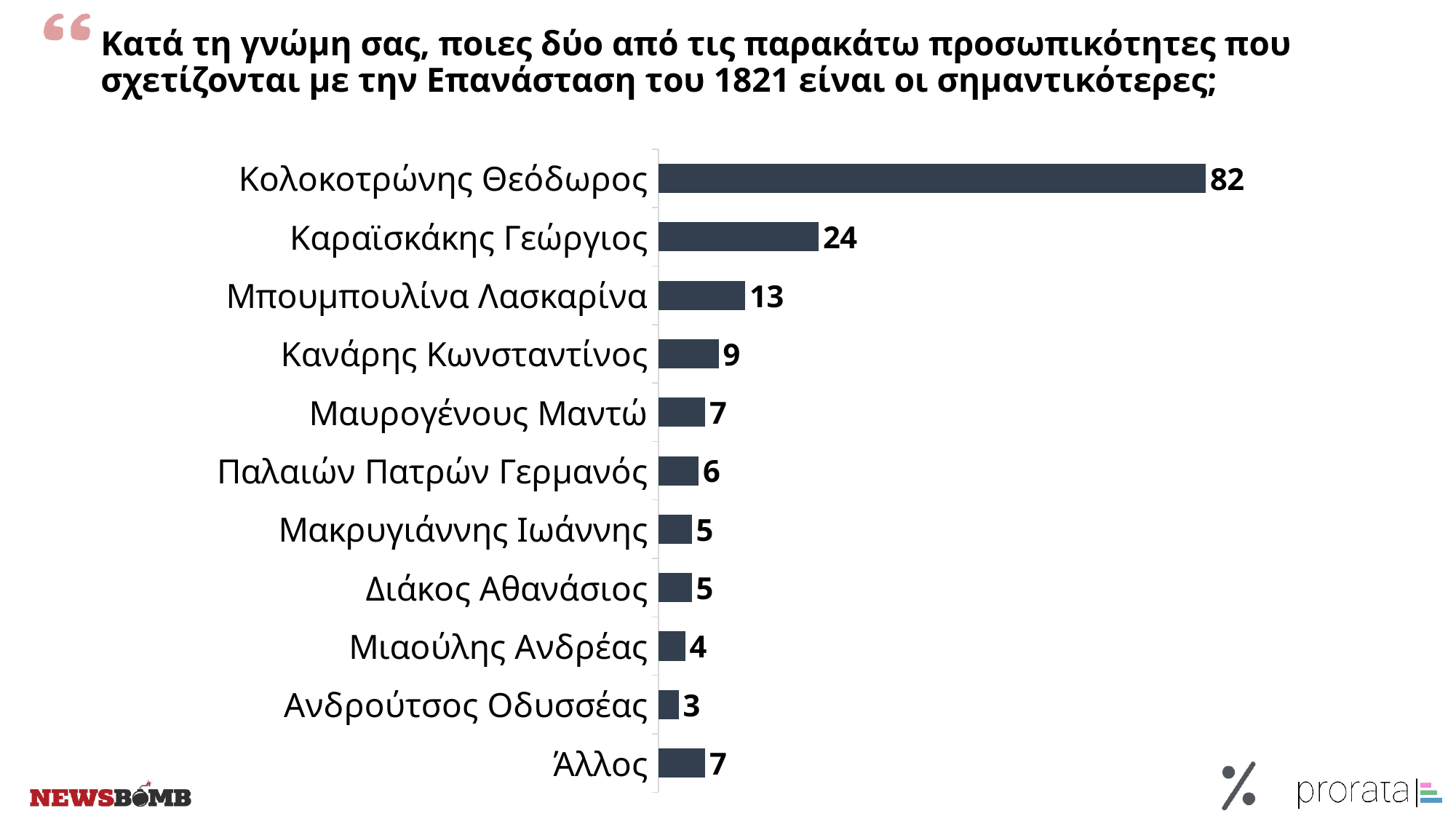
What is the difference between the values for Μπουμπουλίνα Λασκαρίνα and Κανάρης Κωνσταντίνος? 4 Which is larger, the value for Μαυρογένους Μαντώ or the value for Μιαούλης Ανδρέας? Μαυρογένους Μαντώ What is the value for Μπουμπουλίνα Λασκαρίνα? 13 What is the value for Άλλος? 7 How many categories are shown in the chart? 11 What is the value for Καραϊσκάκης Γεώργιος? 24 Which category has the lowest value? Ανδρούτσος Οδυσσέας What kind of chart is shown on the slide? Bar chart What is the difference between the values for Κολοκοτρώνης Θεόδωρος and Καραϊσκάκης Γεώργιος? 58 What is the value for Κολοκοτρώνης Θεόδωρος? 82 What is the value for Ανδρούτσος Οδυσσέας? 3 Which category has the highest value? Κολοκοτρώνης Θεόδωρος